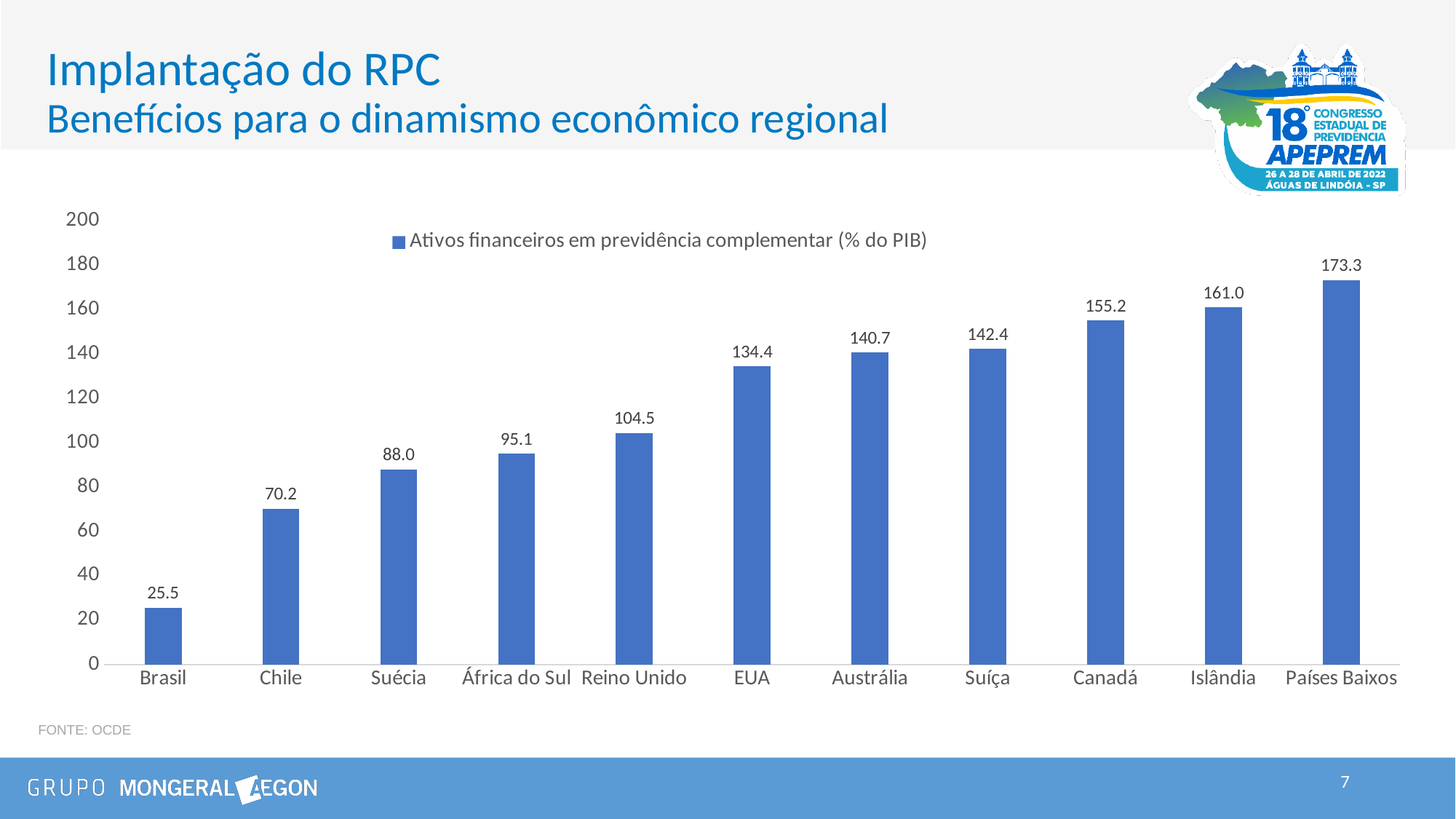
Which has a larger value, EUA or Suécia? EUA What is the value for Brasil? 25.5 Which country has the highest value? Países Baixos How many countries are shown on the chart? 11 What kind of chart is shown on the slide? Bar chart What is the value for Canadá? 155.2 Is the value for Austrália greater or less than 120? greater How many series does the legend list? 1 What is the difference between the values for Islândia and Chile? 90.8 What is the legend entry of the series shown? Ativos financeiros em previdência complementar (% do PIB) Which country has the lowest value? Brasil What is the value for Reino Unido? 104.5